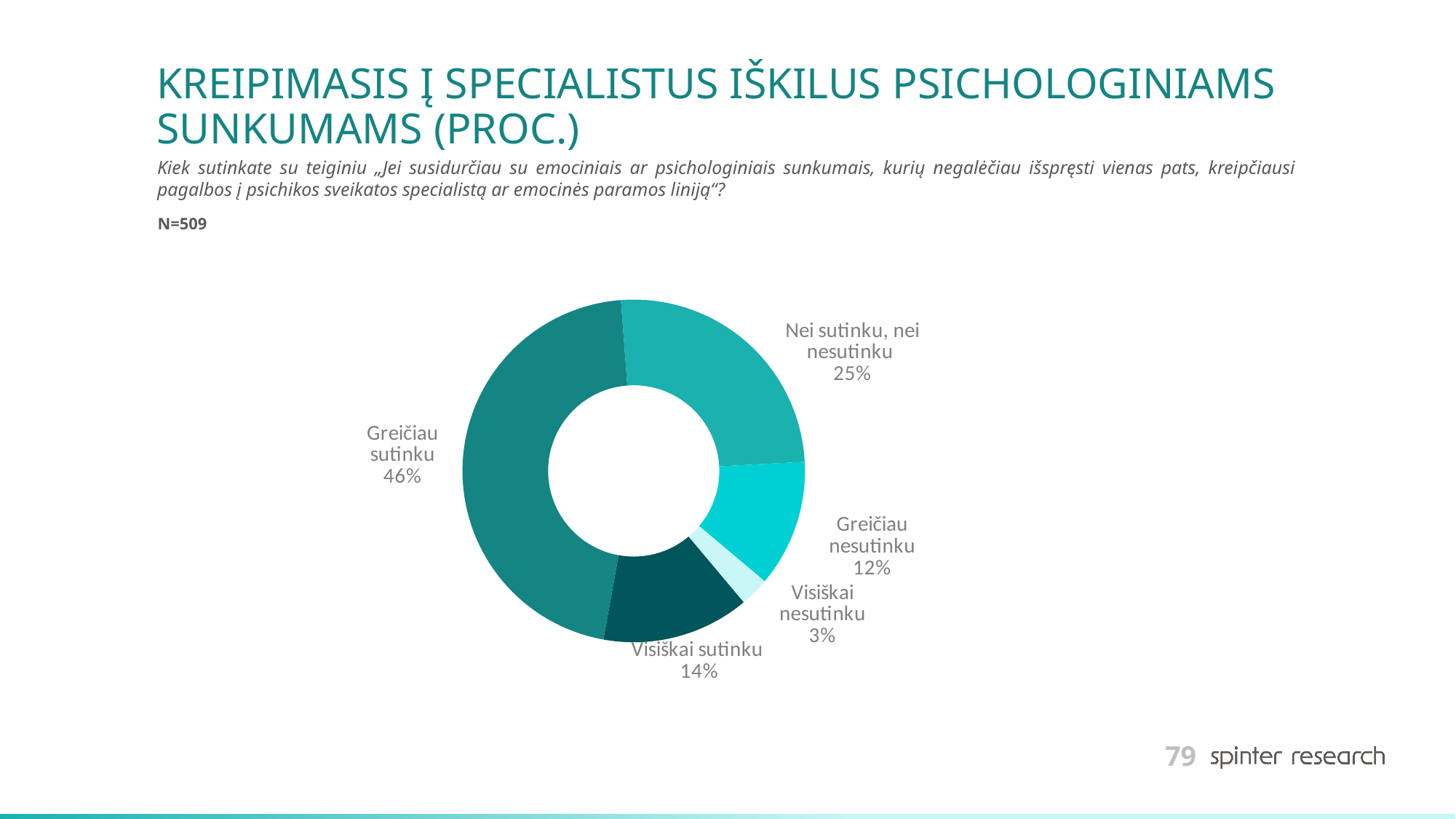
What percentage of respondents answered "Visiškai nesutinku"? 3% What percentage of respondents answered "Greičiau sutinku"? 46% What is the combined share of "Visiškai sutinku" and "Greičiau sutinku"? 60% Which response category has the smallest share of the pie? Visiškai nesutinku What percentage of respondents answered "Visiškai sutinku"? 14% What is the sample size (N) stated on the slide? N=509 What is the difference in percentage points between "Greičiau sutinku" and "Nei sutinku, nei nesutinku"? 21 percentage points How many response categories are shown in the chart? 5 Which response category has the largest share of the pie? Greičiau sutinku What percentage of respondents answered "Nei sutinku, nei nesutinku"? 25% Which is larger: the share for "Visiškai sutinku" or the share for "Greičiau nesutinku"? Visiškai sutinku What type of chart is shown on the slide? Pie chart (doughnut)